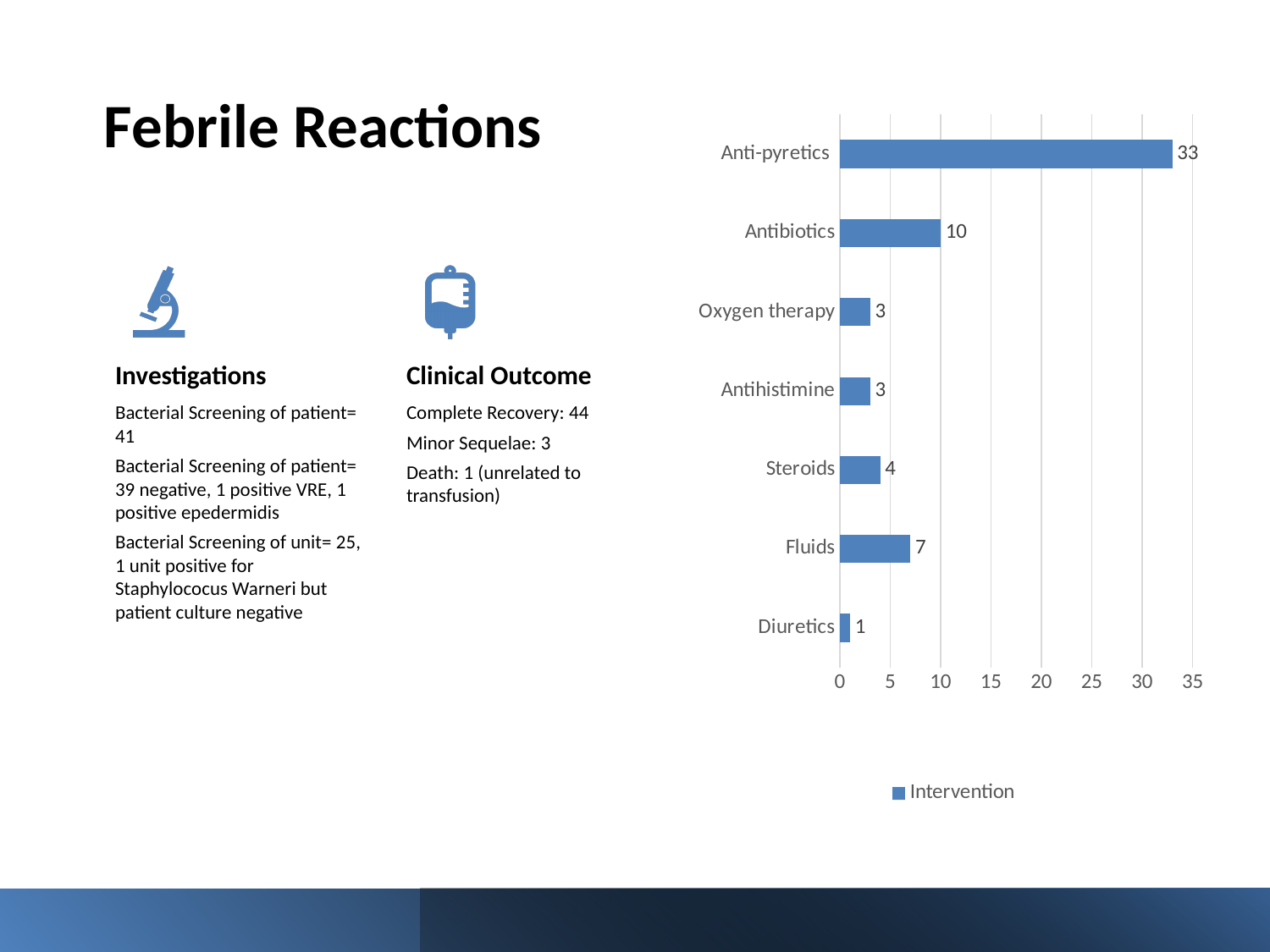
What is the difference between the values for Anti-pyretics and Antibiotics? 23 Which category has the highest value? Anti-pyretics Which is larger, the value for Fluids or the value for Steroids? Fluids Which category has the lowest value? Diuretics How many categories are shown in the chart? 7 What is the value for Anti-pyretics? 33 What is the value for Steroids? 4 What kind of chart is shown on the slide? bar chart Is the value for Antibiotics greater or less than 5? greater What is the value for Fluids? 7 What series name does the legend show? Intervention What is the value for Antibiotics? 10